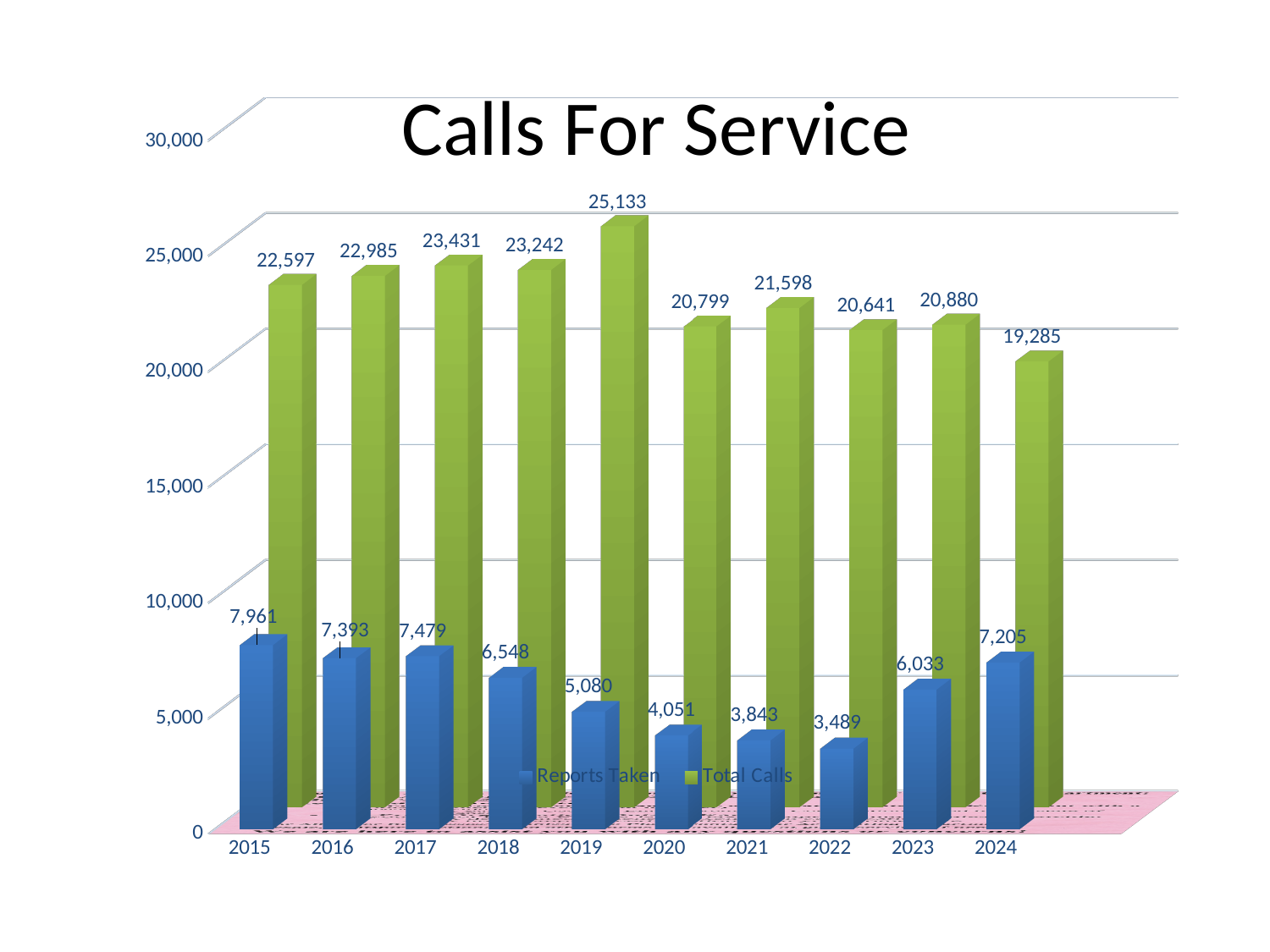
What is the Total Calls value for 2019? 25,133 What is the Total Calls value for 2024? 19,285 Which is larger, Reports Taken in 2023 or Reports Taken in 2024? 2024 Which year has the lowest Reports Taken? 2022 How many years are shown on the x axis? 10 What is the title of the chart? Calls For Service What is the difference between Total Calls and Reports Taken in 2015? 14,636 Which year has the highest Total Calls? 2019 How many series does the legend list? 2 What is the Reports Taken value for 2022? 3,489 Is the Total Calls value for 2020 greater or less than 25,000? less What kind of chart is shown? bar chart